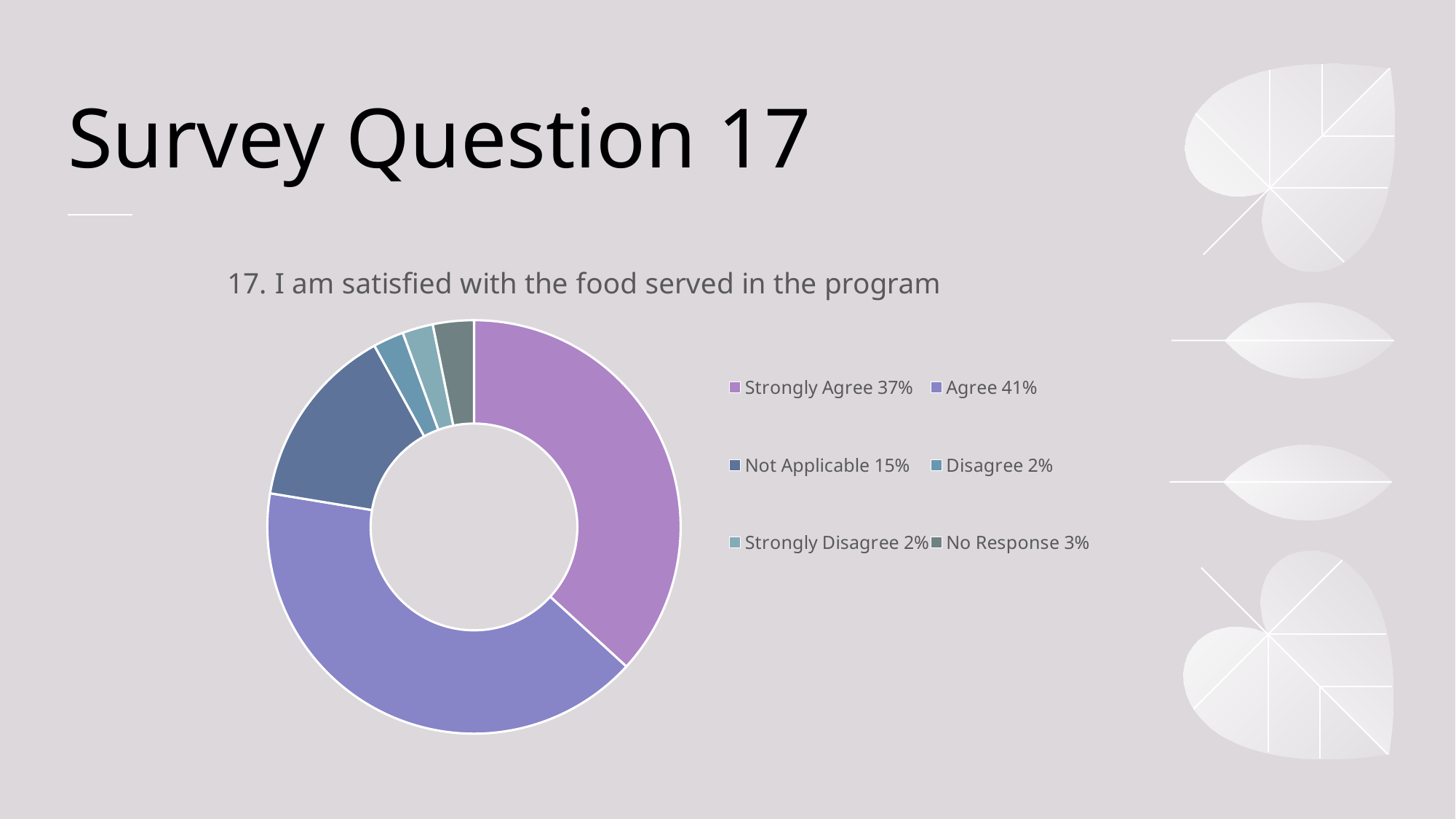
What is the difference in percentage points between Agree and Strongly Agree? 4 What percentage of respondents answered Agree? 41% What kind of chart is shown on the slide? Doughnut chart What percentage of respondents answered Not Applicable? 15% What is the title of the chart? 17. I am satisfied with the food served in the program How many response categories does the chart show? 6 What is the difference in percentage points between Strongly Agree and Not Applicable? 22 What is the combined share of Strongly Agree and Agree? 78% Which is larger, the share for Not Applicable or the share for No Response? Not Applicable What percentage of respondents gave No Response? 3% Which response category has the largest share? Agree What percentage of respondents answered Strongly Agree? 37%